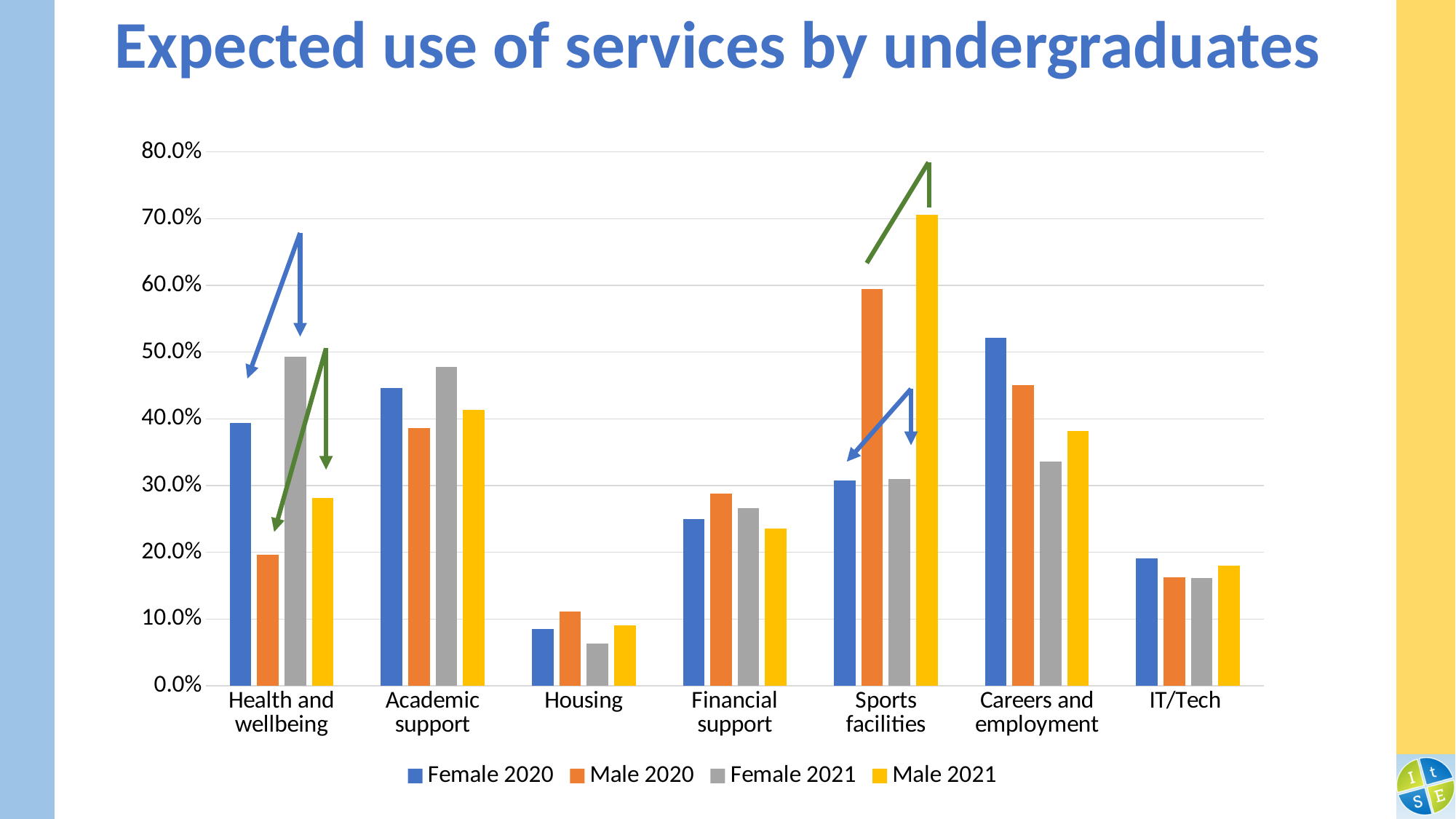
For which category is the Male 2021 value highest? Sports facilities For which category is the Female 2021 value lowest? Housing For Health and wellbeing, which is larger: Female 2021 or Male 2021? Female 2021 Is the Male 2021 value for Sports facilities greater or less than 60.0%? greater Is the Female 2020 value for Careers and employment greater or less than 50.0%? greater For which category is the Female 2020 value highest? Careers and employment For Housing, which is larger: Male 2020 or Female 2021? Male 2020 How many service categories are shown on the x axis? 7 What kind of chart is shown on the slide? Bar chart Which series is shown in yellow in the legend? Male 2021 Is the Male 2020 value for Sports facilities greater or less than 50.0%? greater How many series does the legend list? 4